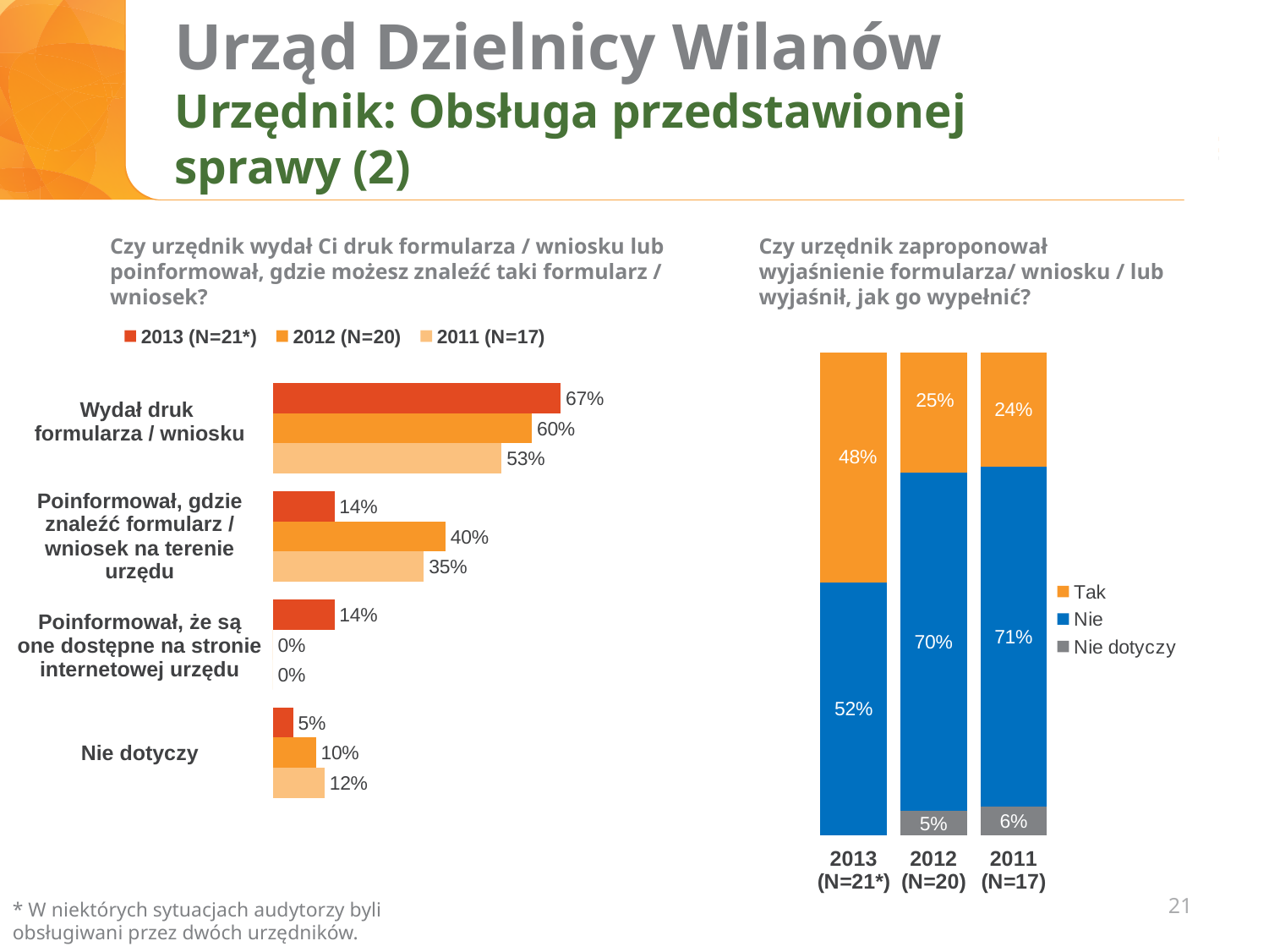
In the left chart, which category has the highest 2013 (N=21*) value? Wydał druk formularza / wniosku In the left chart, what is the difference between the 2013 and 2011 values for "Wydał druk formularza / wniosku"? 14 percentage points What type of chart is the left chart? Bar chart In the left chart, what is the 2012 (N=20) value for "Poinformował, gdzie znaleźć formularz / wniosek na terenie urzędu"? 40% In the right chart, what is the "Nie" value for 2012 (N=20)? 70% In the right chart, what is the "Tak" value for 2013 (N=21*)? 48% In the left chart, how many categories are shown? 4 In the left chart, what is the 2011 (N=17) value for "Nie dotyczy"? 12% In the right chart, is the "Tak" value for 2012 larger or smaller than the "Nie" value for 2012? Smaller In the left chart, what is the 2013 (N=21*) value for "Wydał druk formularza / wniosku"? 67% In the right chart, which year has the highest "Tak" value? 2013 (N=21*) In the left chart, how many series does the legend list? 3